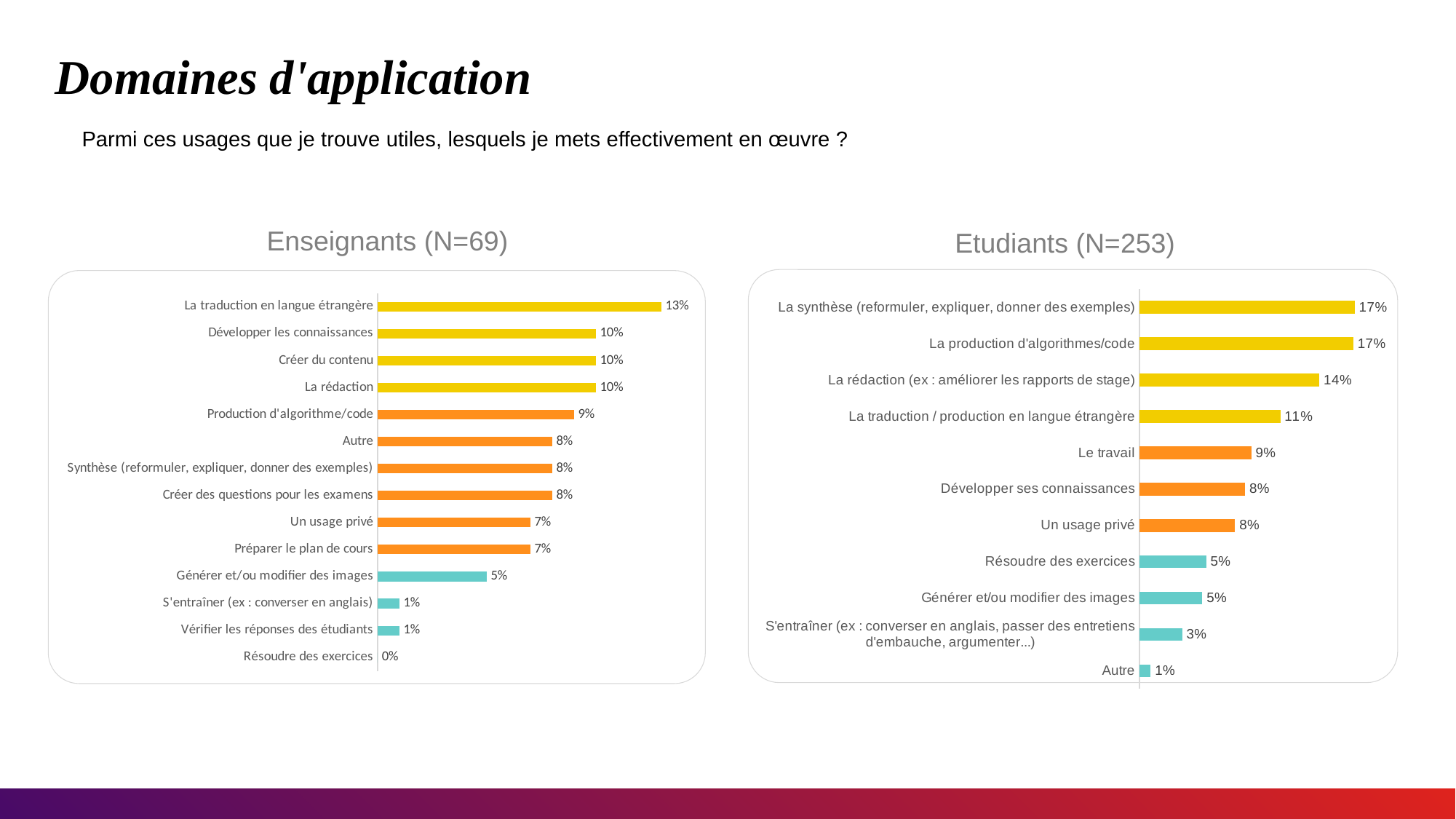
How many categories are shown in the 'Etudiants (N=253)' chart? 11 What type of chart is the 'Etudiants (N=253)' chart? Bar chart In the 'Enseignants (N=69)' chart, which is larger: 'Production d'algorithme/code' or 'Un usage privé'? Production d'algorithme/code In the 'Enseignants (N=69)' chart, what is the difference between 'La traduction en langue étrangère' and 'Générer et/ou modifier des images'? 8% In the 'Etudiants (N=253)' chart, what is the difference between 'La rédaction (ex : améliorer les rapports de stage)' and 'Le travail'? 5% In the 'Etudiants (N=253)' chart, which category has the lowest value? Autre In the 'Etudiants (N=253)' chart, which is larger: 'Le travail' or 'Résoudre des exercices'? Le travail In the 'Etudiants (N=253)' chart, what is the value for 'La rédaction (ex : améliorer les rapports de stage)'? 14% How many categories are shown in the 'Enseignants (N=69)' chart? 14 In the 'Enseignants (N=69)' chart, which category has the lowest value? Résoudre des exercices In the 'Enseignants (N=69)' chart, what is the value for 'La traduction en langue étrangère'? 13% In the 'Enseignants (N=69)' chart, which category has the highest value? La traduction en langue étrangère